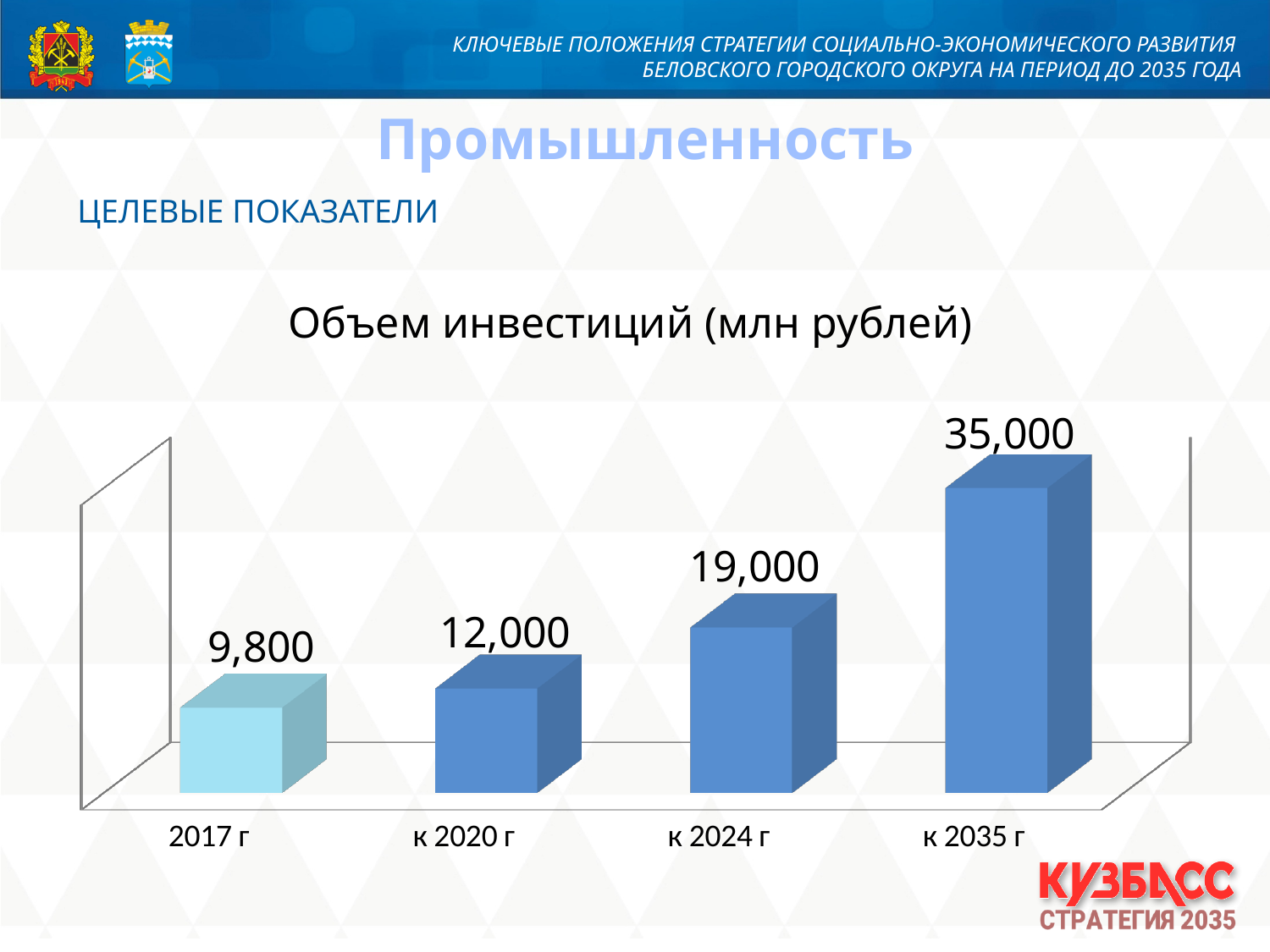
What is the value for к 2020 г? 12,000 What is the value for к 2035 г? 35,000 What is the value for к 2024 г? 19,000 Do the values rise or fall from 2017 г to к 2035 г? rise What is the difference between the values for к 2035 г and к 2024 г? 16,000 Which category has the lowest value? 2017 г Which category has the highest value? к 2035 г What is the difference between the values for к 2020 г and 2017 г? 2,200 How many categories are shown on the chart? 4 What kind of chart is this? bar chart Which is larger, the value for к 2024 г or the value for к 2020 г? к 2024 г What is the value for 2017 г? 9,800